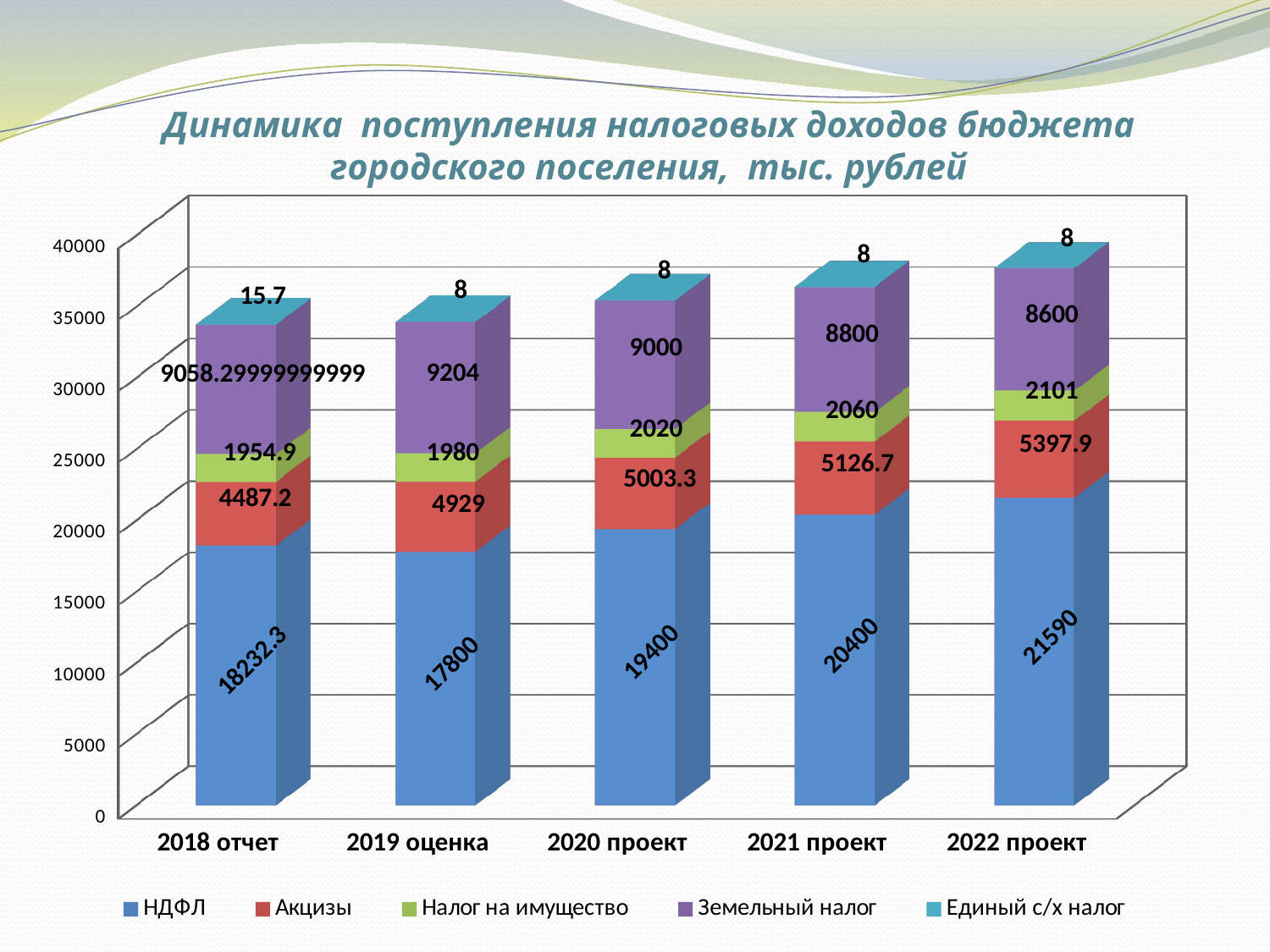
How many series does the legend list? 5 What is the difference between the НДФЛ values for 2022 проект and 2021 проект? 1190 Do the values for Акцизы rise or fall from 2018 отчет to 2022 проект? Rise Which is larger, Земельный налог for 2020 проект or for 2021 проект? 2020 проект Which category has the lowest value for Земельный налог? 2022 проект What kind of chart is shown on the slide? Stacked bar chart What is the value of Единый с/х налог for 2018 отчет? 15.7 Which category has the highest value for НДФЛ? 2022 проект How many categories are shown on the x axis? 5 What is the value of Земельный налог for 2019 оценка? 9204 What is the value of НДФЛ for 2022 проект? 21590 What is the value of Акцизы for 2020 проект? 5003.3